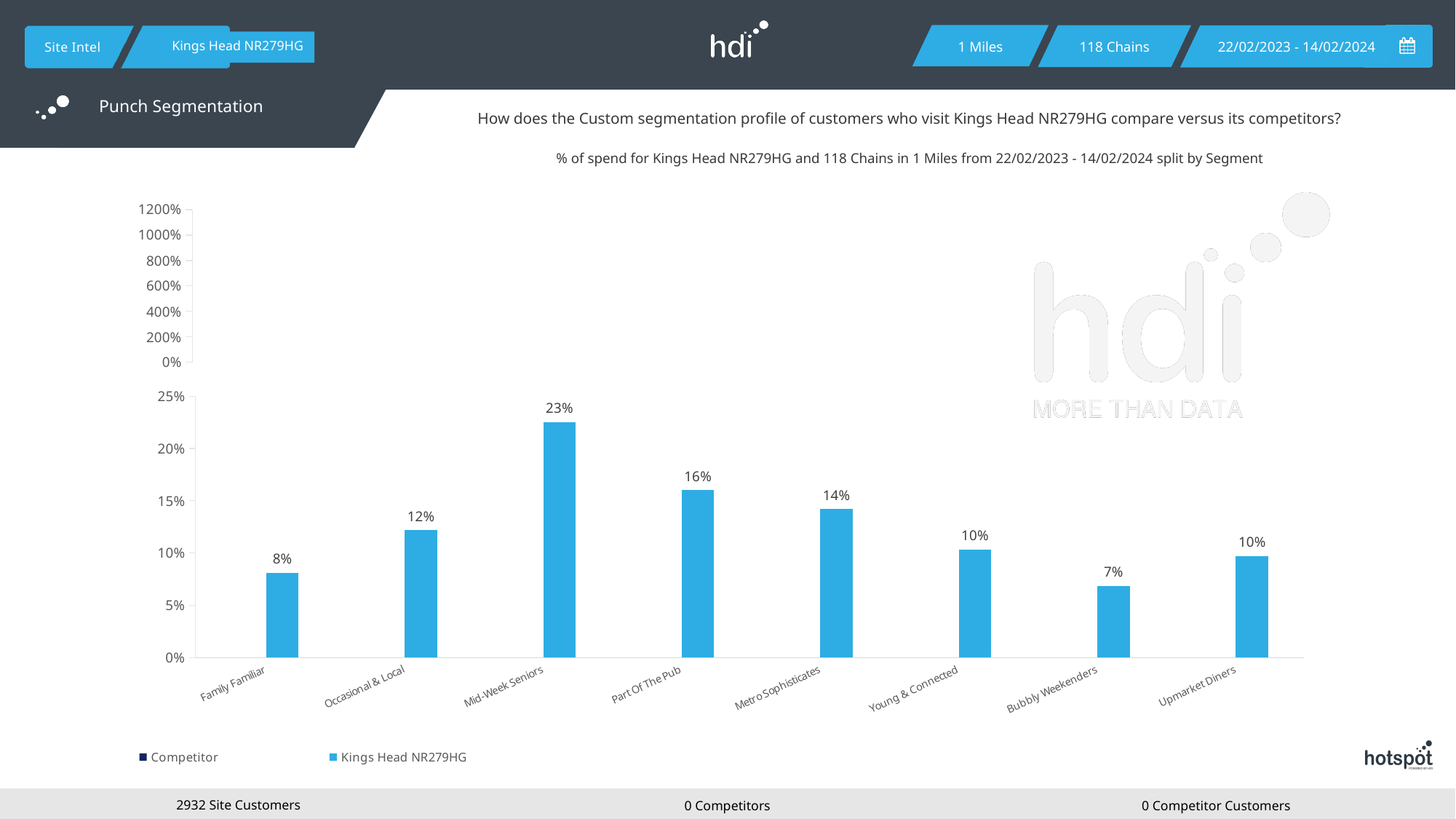
What is the value for Metro Sophisticates for Kings Head NR279HG? 14% How many segments are shown on the x axis of the chart? 8 What is the difference between the Mid-Week Seniors and Family Familiar values for Kings Head NR279HG? 15% Which series is shown in light blue in the legend? Kings Head NR279HG What kind of chart is shown on the slide? Bar chart Which segment has the highest value for Kings Head NR279HG? Mid-Week Seniors How many series does the chart legend list? 2 What is the value for Part Of The Pub for Kings Head NR279HG? 16% What is the value for Bubbly Weekenders for Kings Head NR279HG? 7% What is the value for Mid-Week Seniors for Kings Head NR279HG? 23% Which is larger for Kings Head NR279HG: Occasional & Local or Metro Sophisticates? Metro Sophisticates Which segment has the lowest value for Kings Head NR279HG? Bubbly Weekenders